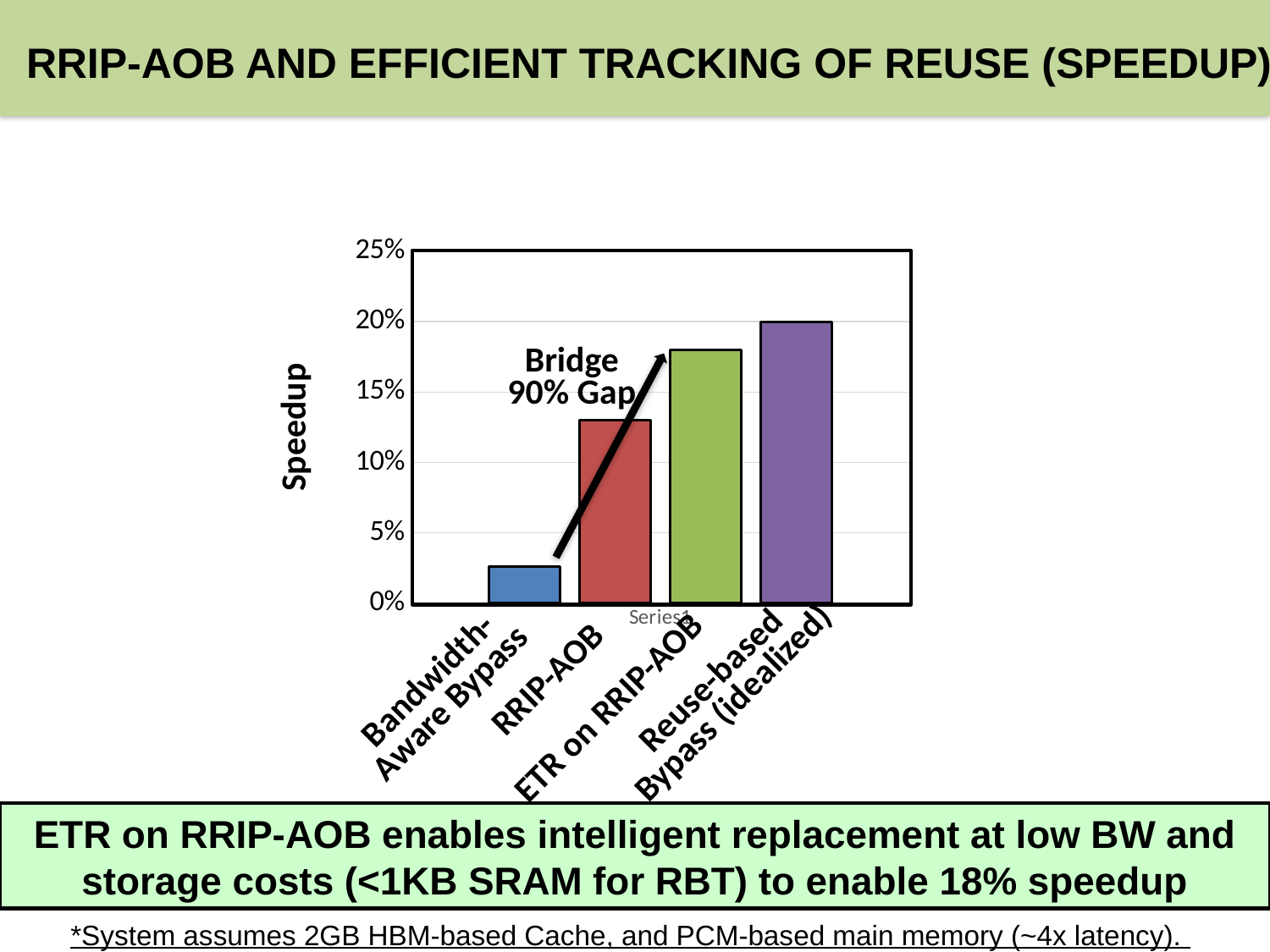
Which has the larger speedup, RRIP-AOB or ETR on RRIP-AOB? ETR on RRIP-AOB Which category has the lowest speedup in the chart? Bandwidth-Aware Bypass Is the speedup for Reuse-based Bypass (idealized) greater or less than 15%? greater How many bars (categories) are plotted in the chart? 4 Do the bar values rise or fall from left to right along the x axis? rise Is the speedup for Bandwidth-Aware Bypass greater or less than 5%? less Is the speedup for RRIP-AOB greater or less than 15%? less What kind of chart is shown on the slide? bar chart Which category has the highest speedup in the chart? Reuse-based Bypass (idealized) What is the label on the vertical axis of the chart? Speedup